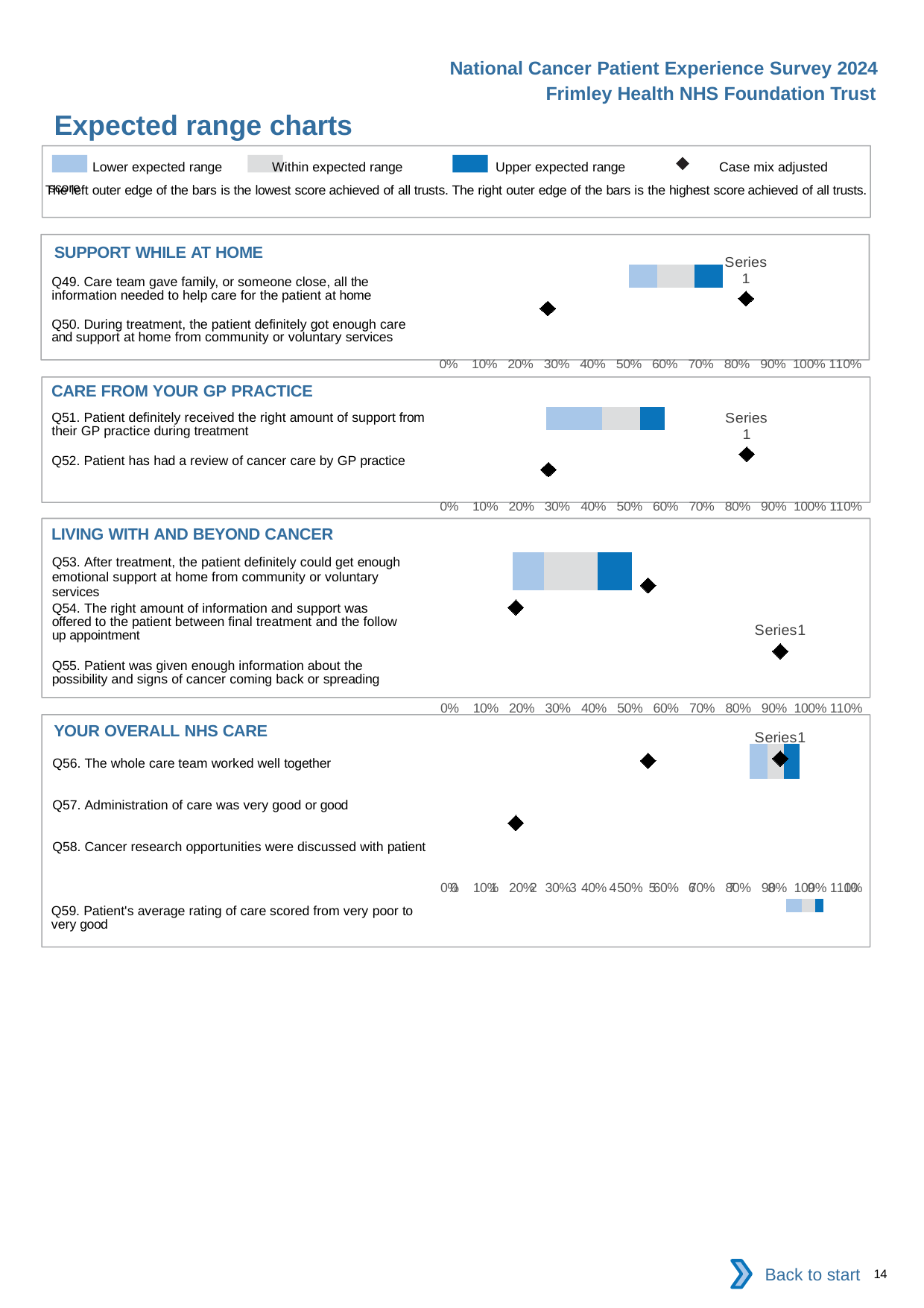
What is the highest percentage tick shown on the x axis of the Living with and beyond cancer chart? 110% In the Care from your GP practice chart, is the rightmost diamond marker greater or less than 70%? greater How many questions are listed in the Your overall NHS care chart? 4 What is the title of the slide's charts section? Expected range charts In the Support while at home chart, is the rightmost diamond marker greater or less than 70%? greater In the Support while at home chart, is the leftmost diamond marker greater or less than 40%? less How many entries does the legend at the top of the slide list? 4 How many questions are listed in the Living with and beyond cancer chart? 3 What kind of chart is used in the Support while at home section? bar chart How many questions are listed in the Care from your GP practice chart? 2